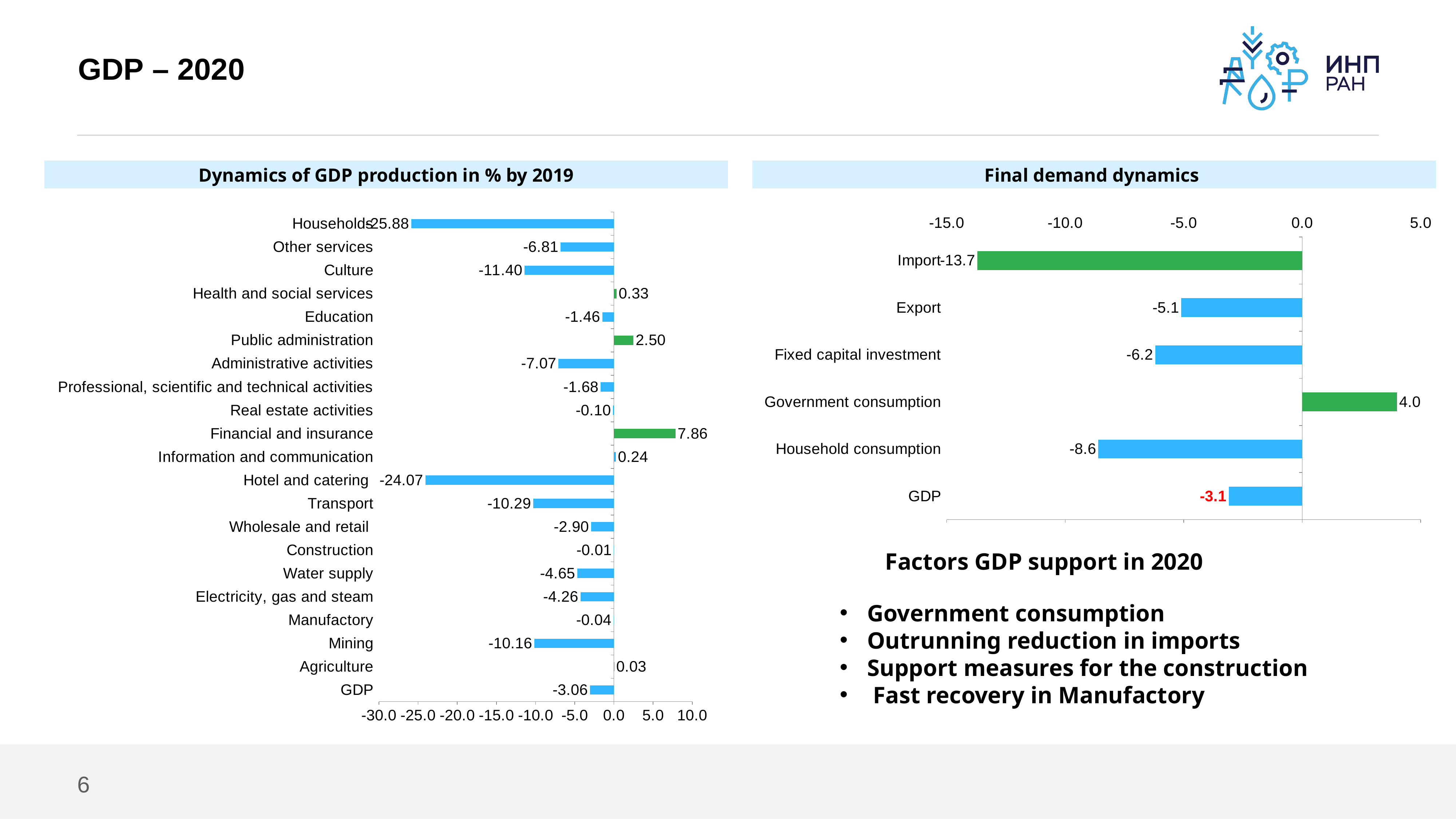
How many categories are shown in the 'Final demand dynamics' chart? 6 In the 'Final demand dynamics' chart, which category has the highest value? Government consumption In the 'Dynamics of GDP production in % by 2019' chart, which category has the highest value? Financial and insurance What kind of chart is the 'Final demand dynamics' chart? Bar chart In the 'Dynamics of GDP production in % by 2019' chart, what is the value for Hotel and catering? -24.07 In the 'Final demand dynamics' chart, what is the value for Import? -13.7 How many categories are shown in the 'Dynamics of GDP production in % by 2019' chart? 21 In the 'Final demand dynamics' chart, what is the difference between the values for Household consumption and Fixed capital investment? 2.4 In the 'Dynamics of GDP production in % by 2019' chart, which is larger, the value for Culture or the value for Other services? Other services In the 'Dynamics of GDP production in % by 2019' chart, what is the difference between the values for Transport and Mining? 0.13 In the 'Dynamics of GDP production in % by 2019' chart, which category has the lowest value? Households In the 'Dynamics of GDP production in % by 2019' chart, what is the value for Financial and insurance? 7.86